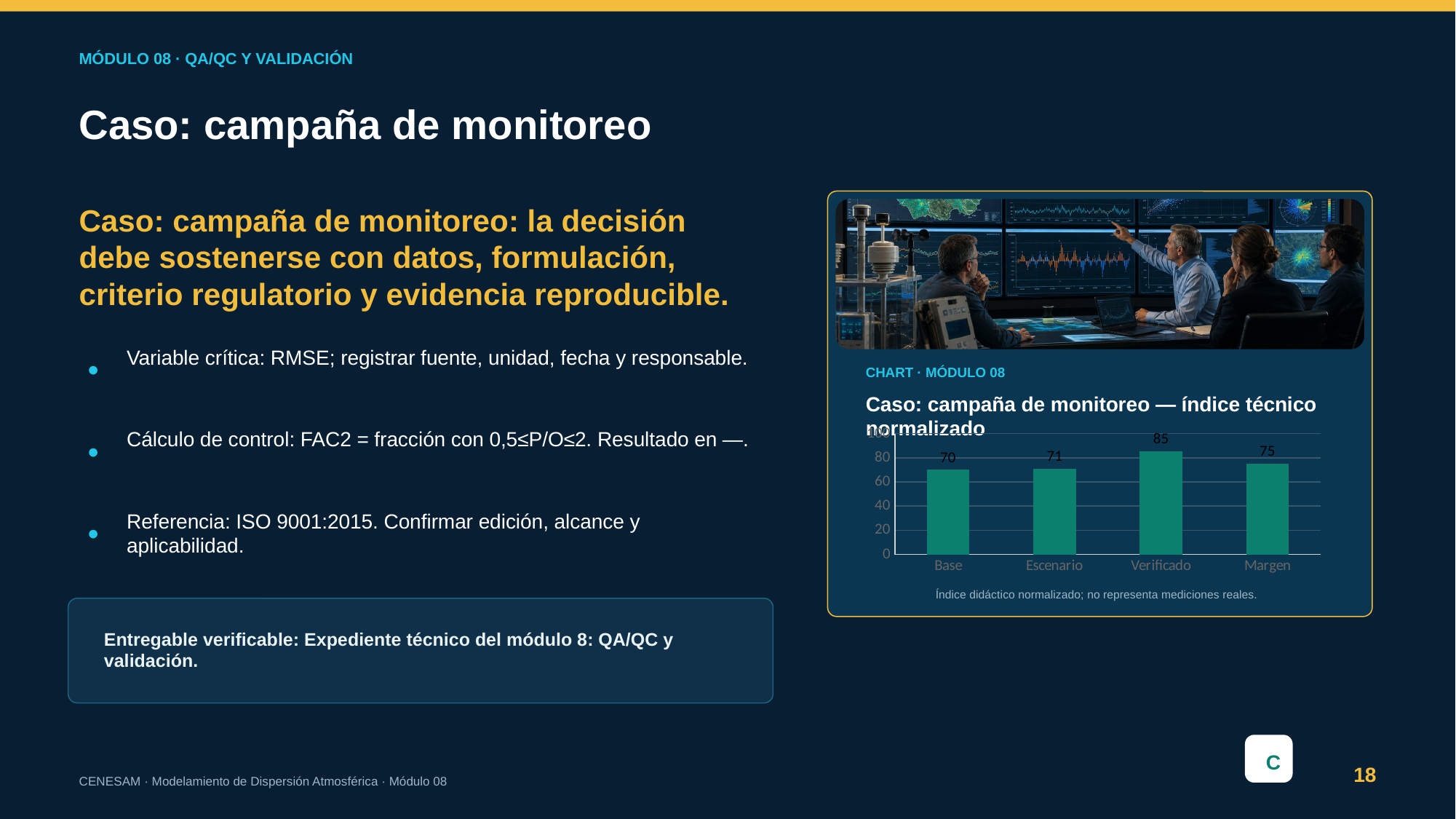
What is the title of the chart? Caso: campaña de monitoreo — índice técnico normalizado What is the value for Escenario? 71 Which category has the lowest value? Base What is the difference between the values for Verificado and Base? 15 What is the value for Base? 70 Which category has the highest value? Verificado What is the value for Verificado? 85 What is the value for Margen? 75 Which is larger, the value for Verificado or the value for Margen? Verificado What kind of chart is shown on the slide? Bar chart What is the difference between the values for Margen and Escenario? 4 How many categories are shown on the x axis? 4